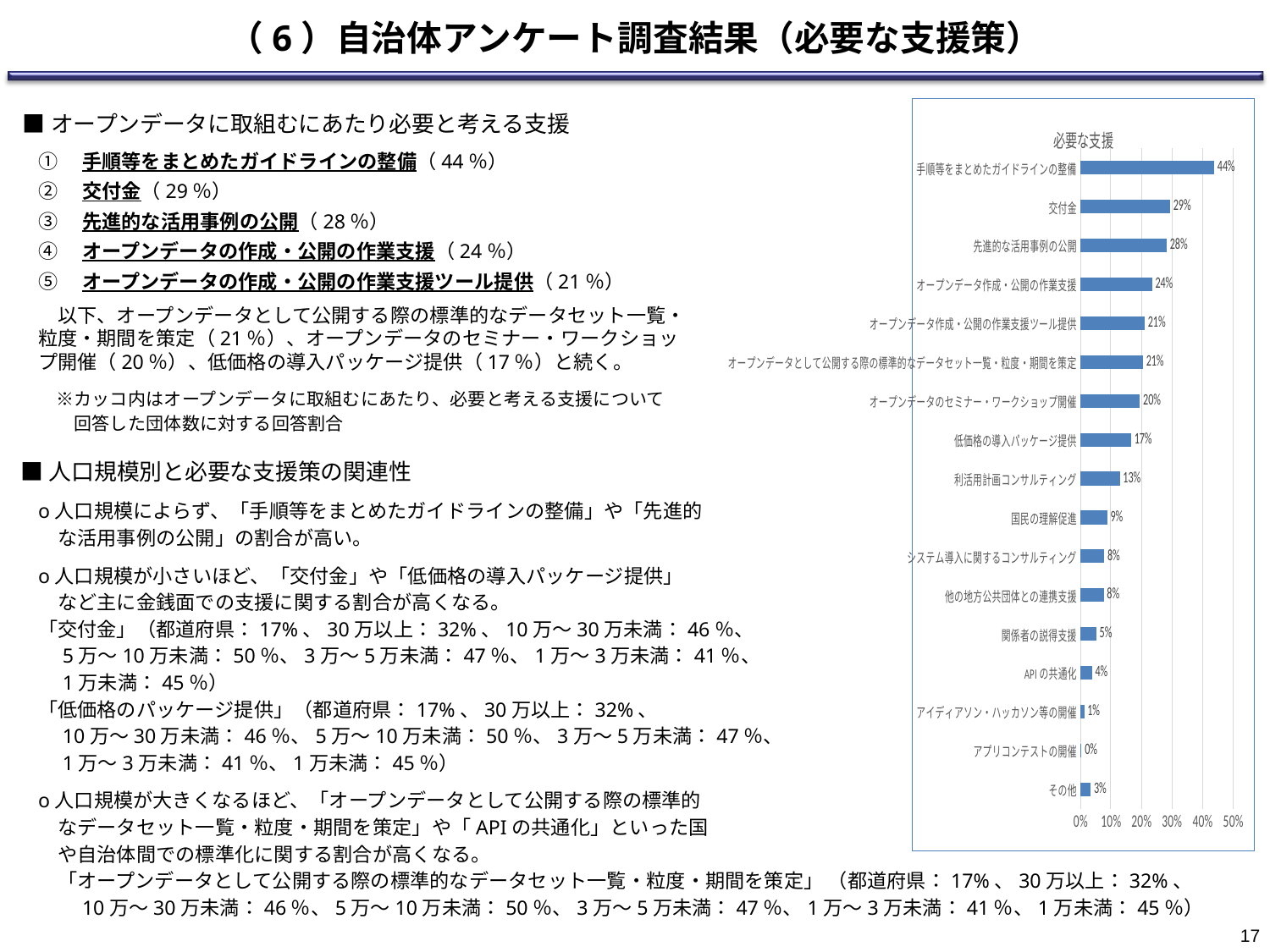
How many categories are shown in the chart? 17 What is the value for 交付金? 29% Which category has the highest value? 手順等をまとめたガイドラインの整備 What type of chart is shown on the slide? bar chart What is the value for 国民の理解促進? 9% What is the value for 手順等をまとめたガイドラインの整備? 44% What is the value for 低価格の導入パッケージ提供? 17% Which is larger, the value for 先進的な活用事例の公開 or the value for 利活用計画コンサルティング? 先進的な活用事例の公開 What is the value for APIの共通化? 4% Which category has the lowest value? アプリコンテストの開催 What is the difference between the values for 手順等をまとめたガイドラインの整備 and 交付金? 15% What is the title of the chart? 必要な支援